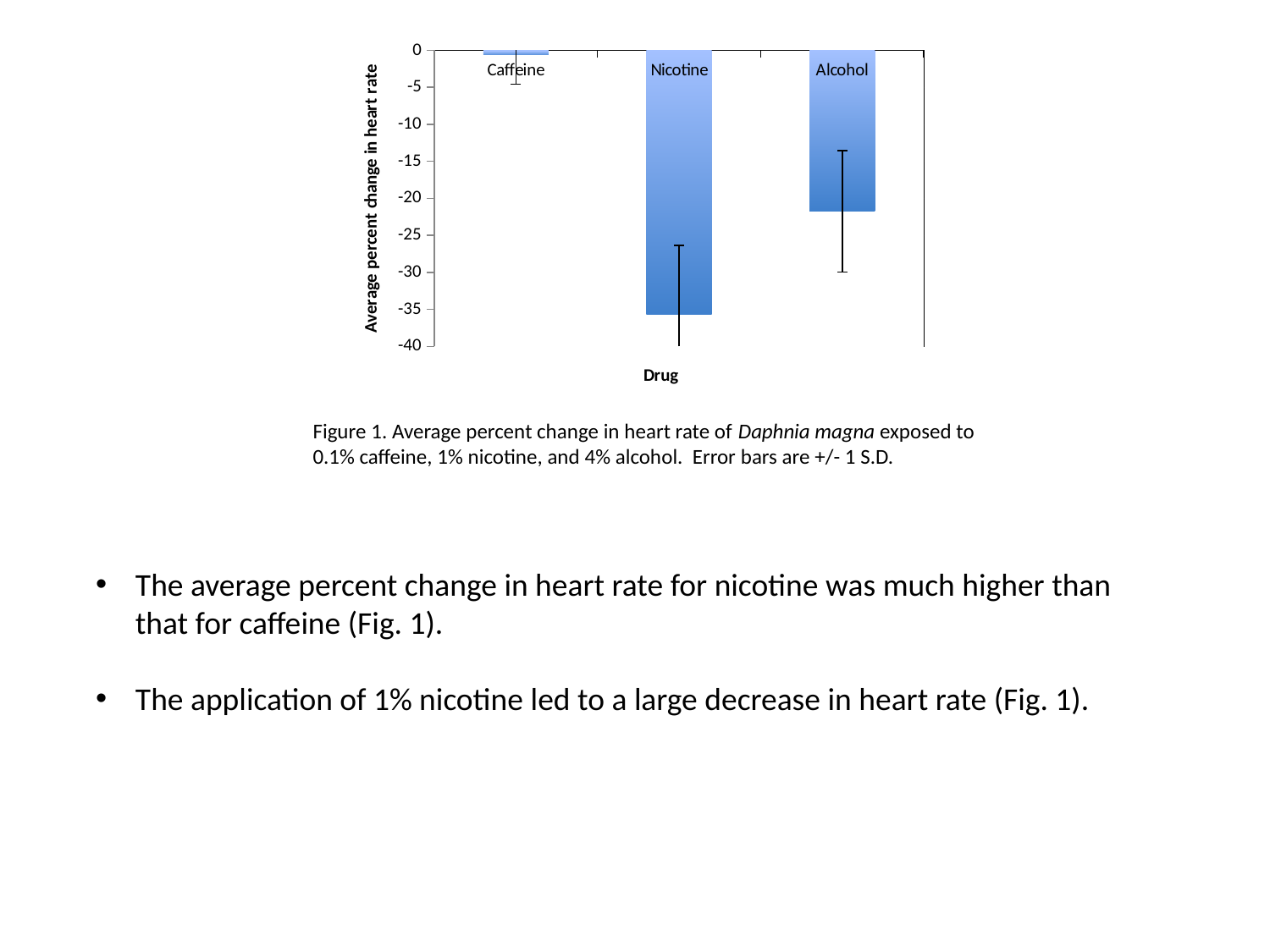
Which drug has the highest (closest to zero) average percent change in heart rate? Caffeine What kind of chart is shown on the slide? bar chart How many drugs (categories) are plotted on the x axis? 3 Which has a larger (less negative) average percent change in heart rate, Caffeine or Alcohol? Caffeine Which drug has the lowest (most negative) average percent change in heart rate? Nicotine What is the label of the x axis? Drug Is the value for Nicotine greater or less than -30? less Which has a larger (less negative) average percent change in heart rate, Alcohol or Nicotine? Alcohol Is the value for Alcohol greater or less than -25? greater Is the value for Caffeine greater or less than -5? greater What is the label of the y axis? Average percent change in heart rate